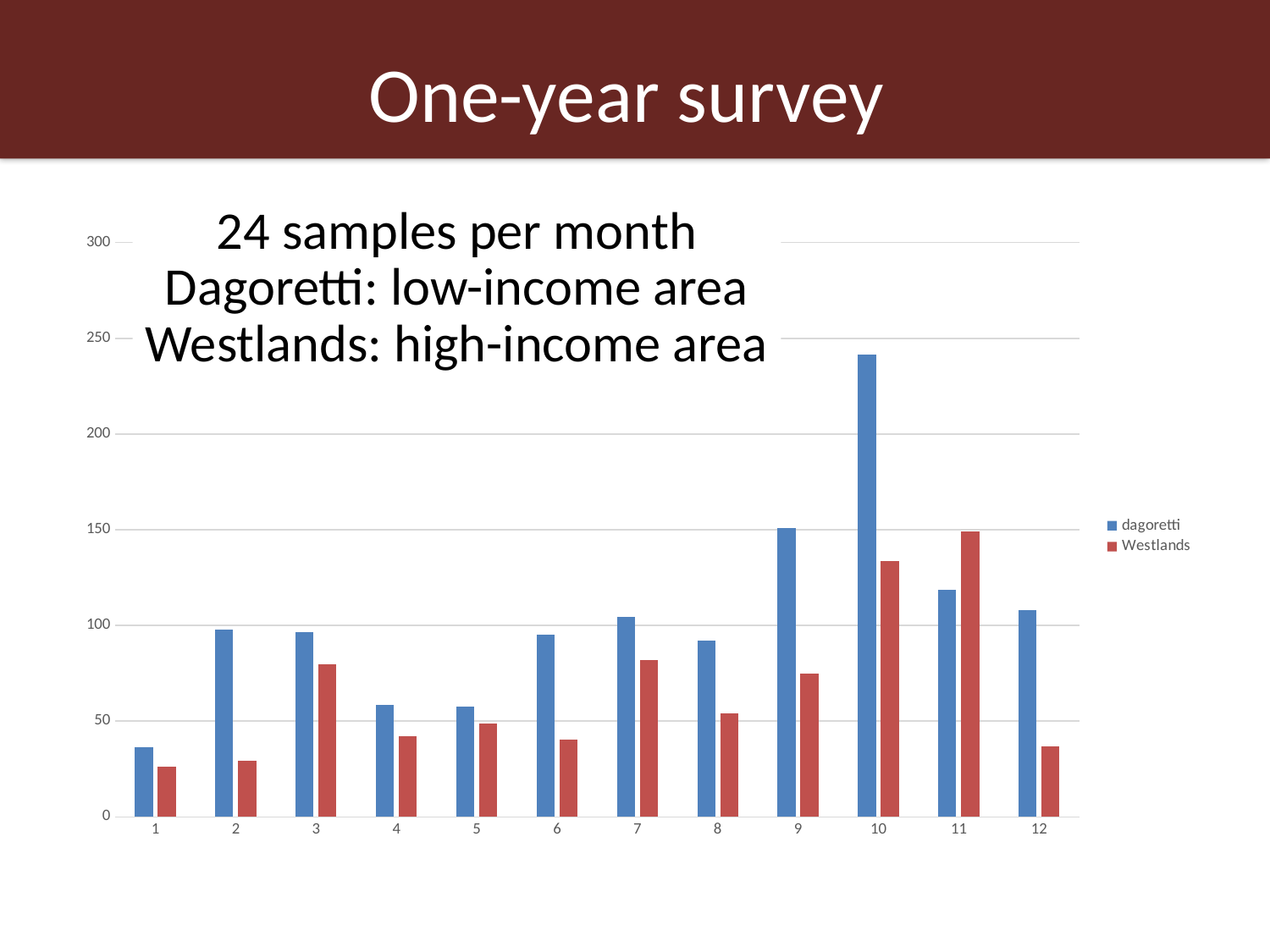
In which month is the dagoretti value highest? 10 How many months (categories) are shown on the x axis? 12 What kind of chart is shown on the slide? bar chart In month 10, which series has the larger value, dagoretti or Westlands? dagoretti How many series does the legend list? 2 Is the Westlands value for month 3 greater or less than 100? less In month 11, which series has the larger value, dagoretti or Westlands? Westlands Which series is shown in red in the legend? Westlands In which month is the Westlands value highest? 11 In which month is the dagoretti value lowest? 1 Is the dagoretti value for month 1 greater or less than 50? less Is the dagoretti value for month 10 greater or less than 200? greater